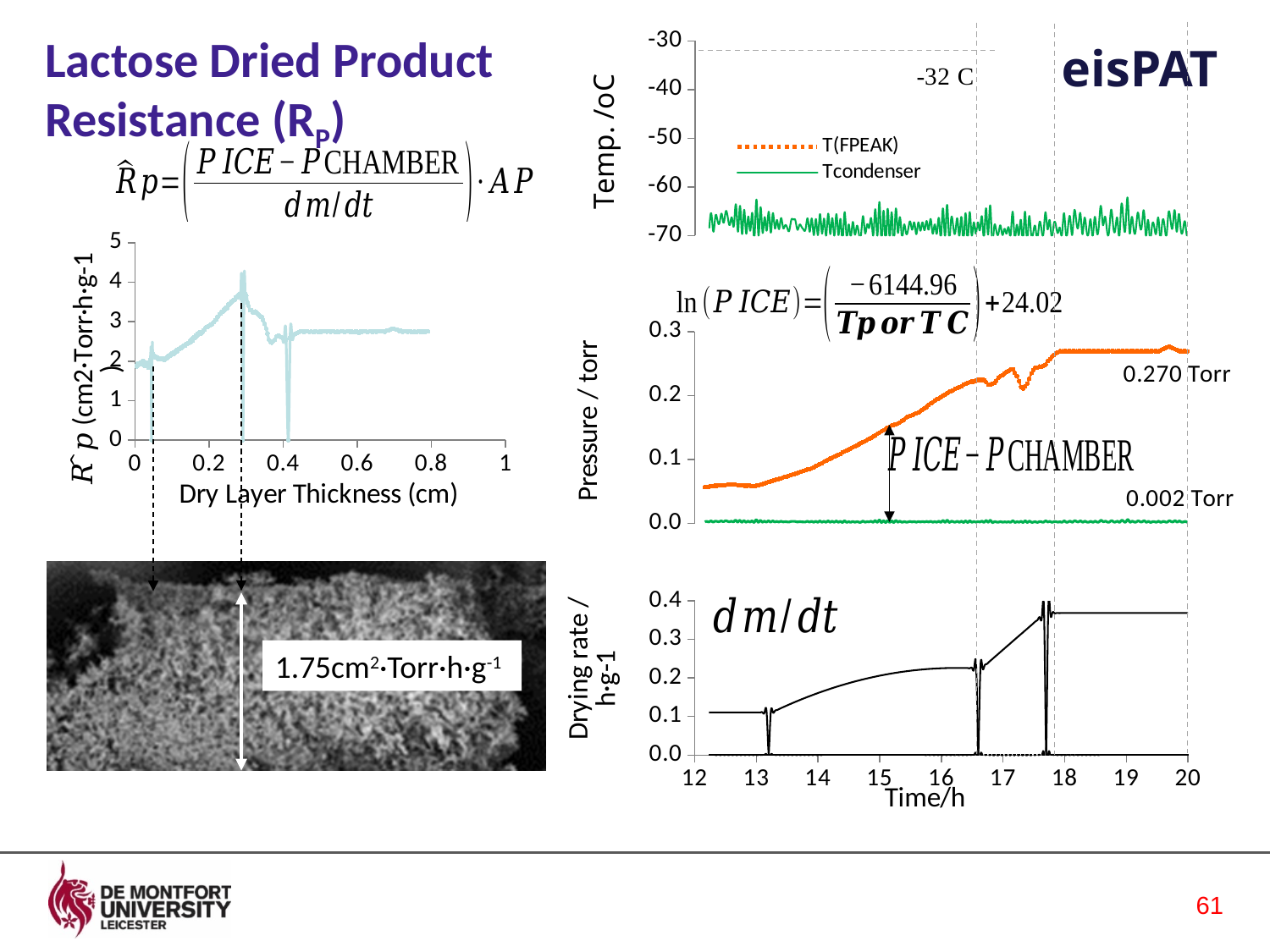
On the Pressure / torr chart, what value is labelled for the green (P CHAMBER) line? 0.002 Torr On the Rp versus Dry Layer Thickness chart, is the value of Rp at a dry layer thickness of 0.6 cm greater or less than 2? greater On the temperature chart at the top right, is the Tcondenser value greater or less than -60? less On the Drying rate chart at the bottom right, is the drying rate at 19 h greater or less than 0.3? greater On the temperature chart at the top right, how many series does the legend list? 2 What type of chart is the Rp versus Dry Layer Thickness chart on the left of the slide? line chart On the Rp versus Dry Layer Thickness chart, what is the label of the x axis? Dry Layer Thickness (cm) On the Pressure / torr chart, does the orange P ICE line rise or fall as time increases from 12 h to 18 h? rise On the temperature chart at the top right, what are the two series named in the legend? T(FPEAK) and Tcondenser On the Pressure / torr chart, what is the difference between the labelled values 0.270 Torr and 0.002 Torr? 0.268 Torr On the Pressure / torr chart, what value is labelled for the orange (P ICE) line at the end of the run? 0.270 Torr